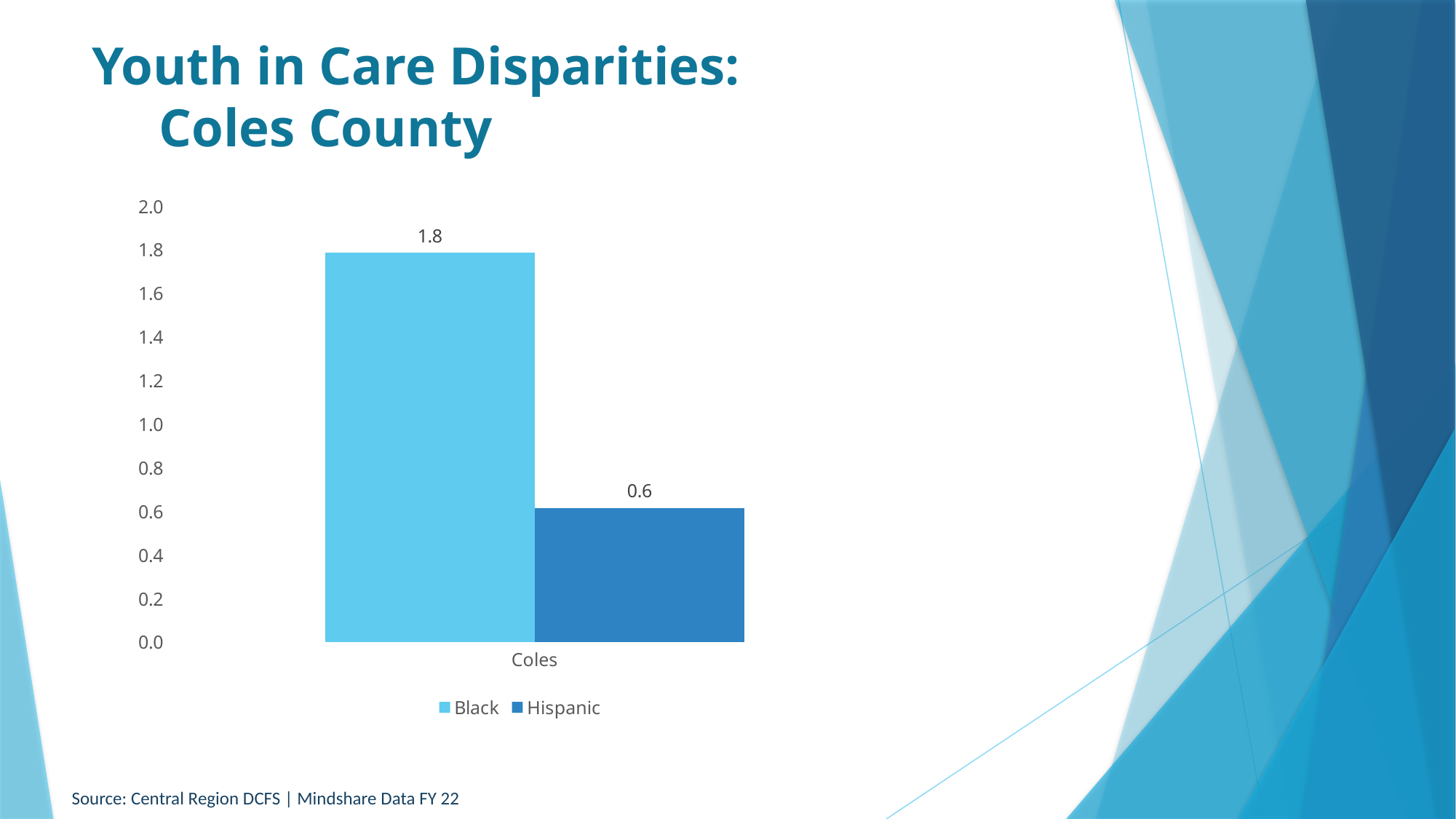
What is the value for Black in Coles? 1.8 Which series has the lower value for Coles? Hispanic What kind of chart is shown on the slide? bar chart Is the value for Black in Coles greater or less than 1.0? greater Is the value for Black or Hispanic larger in Coles? Black Is the value for Hispanic in Coles greater or less than 1.0? less What is the value for Hispanic in Coles? 0.6 What is the difference between the Black and Hispanic values for Coles? 1.2 Which series has the higher value for Coles? Black What is the maximum value shown on the vertical axis? 2.0 How many series does the legend list? 2 How many categories are shown on the x axis? 1